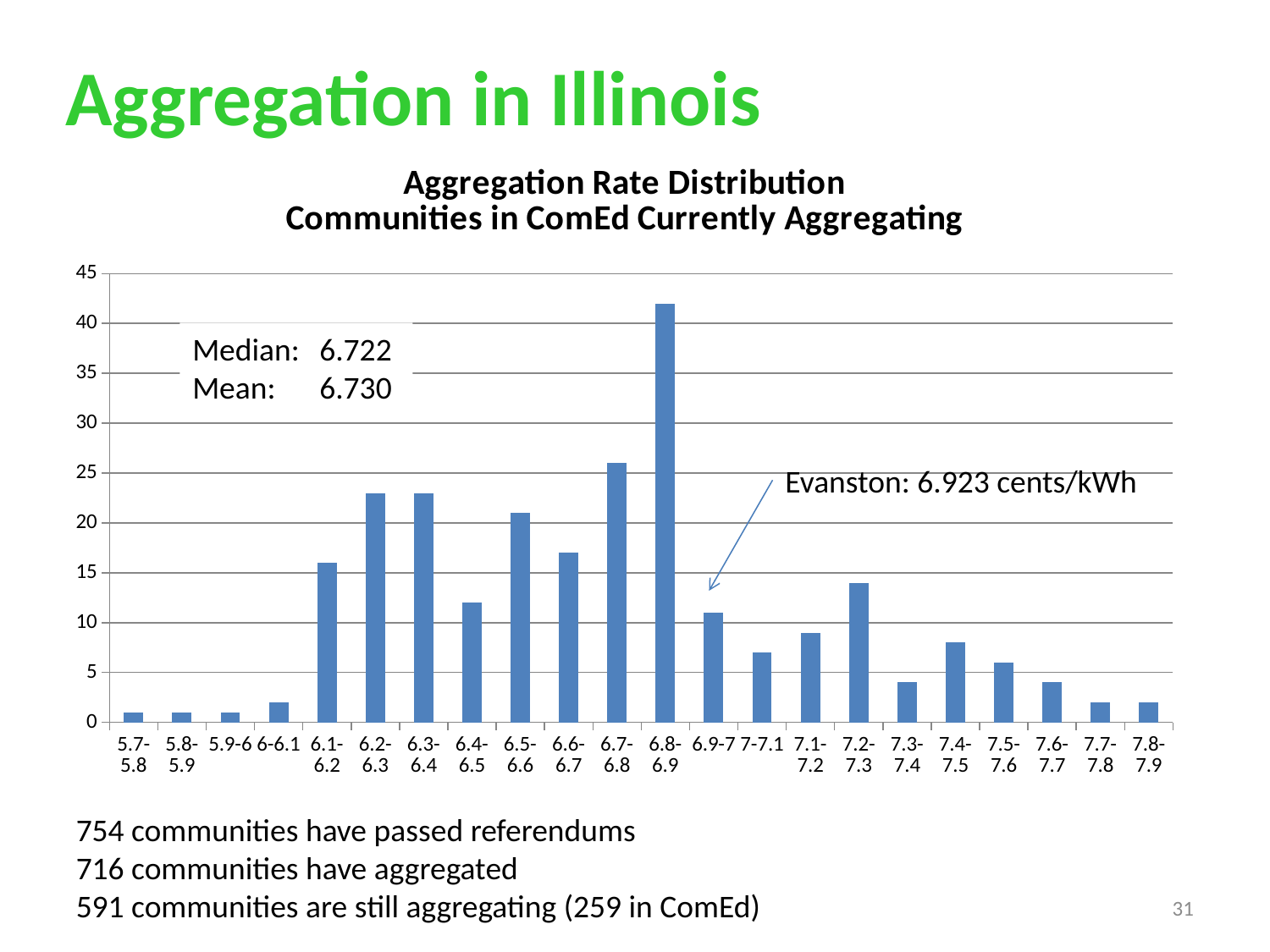
How many rate ranges are shown on the x axis? 22 What median value is printed on the chart? 6.722 What rate is given for Evanston on the chart? 6.923 cents/kWh Which has more communities, the 6.1-6.2 range or the 6.4-6.5 range? 6.1-6.2 Which rate range has the highest number of communities? 6.8-6.9 Is the value for the 6.8-6.9 range greater or less than 40? greater Is the value for the 7-7.1 range greater or less than 10? less Is the value for the 6.1-6.2 range greater or less than 15? greater What kind of chart is shown on the slide? bar chart Which has more communities, the 6.8-6.9 range or the 6.7-6.8 range? 6.8-6.9